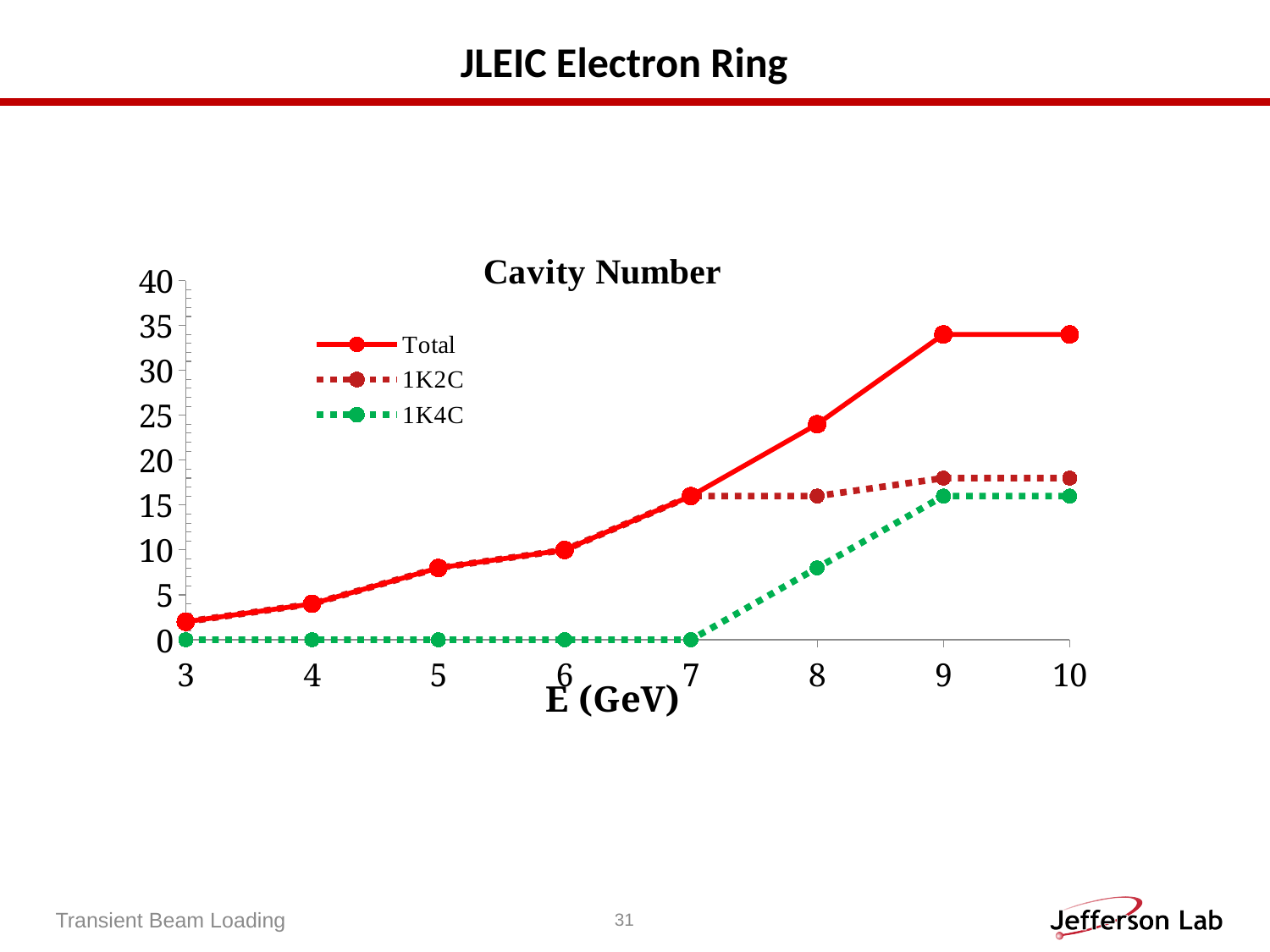
What is the title of the chart? Cavity Number What kind of chart is shown on the slide? line chart How many energy points are plotted along the x axis? 8 What is the Total cavity number at 6 GeV? 10 What is the label of the x axis? E (GeV) Is the Total value at 8 GeV greater or less than 20? greater How many series does the legend list? 3 Does the Total series rise or fall as E increases from 3 to 9 GeV? rise At 10 GeV, which series has the higher value, Total or 1K4C? Total What is the 1K4C cavity number at 5 GeV? 0 Is the Total value at 9 GeV greater or less than 30? greater Is the 1K2C value at 10 GeV greater or less than 20? less